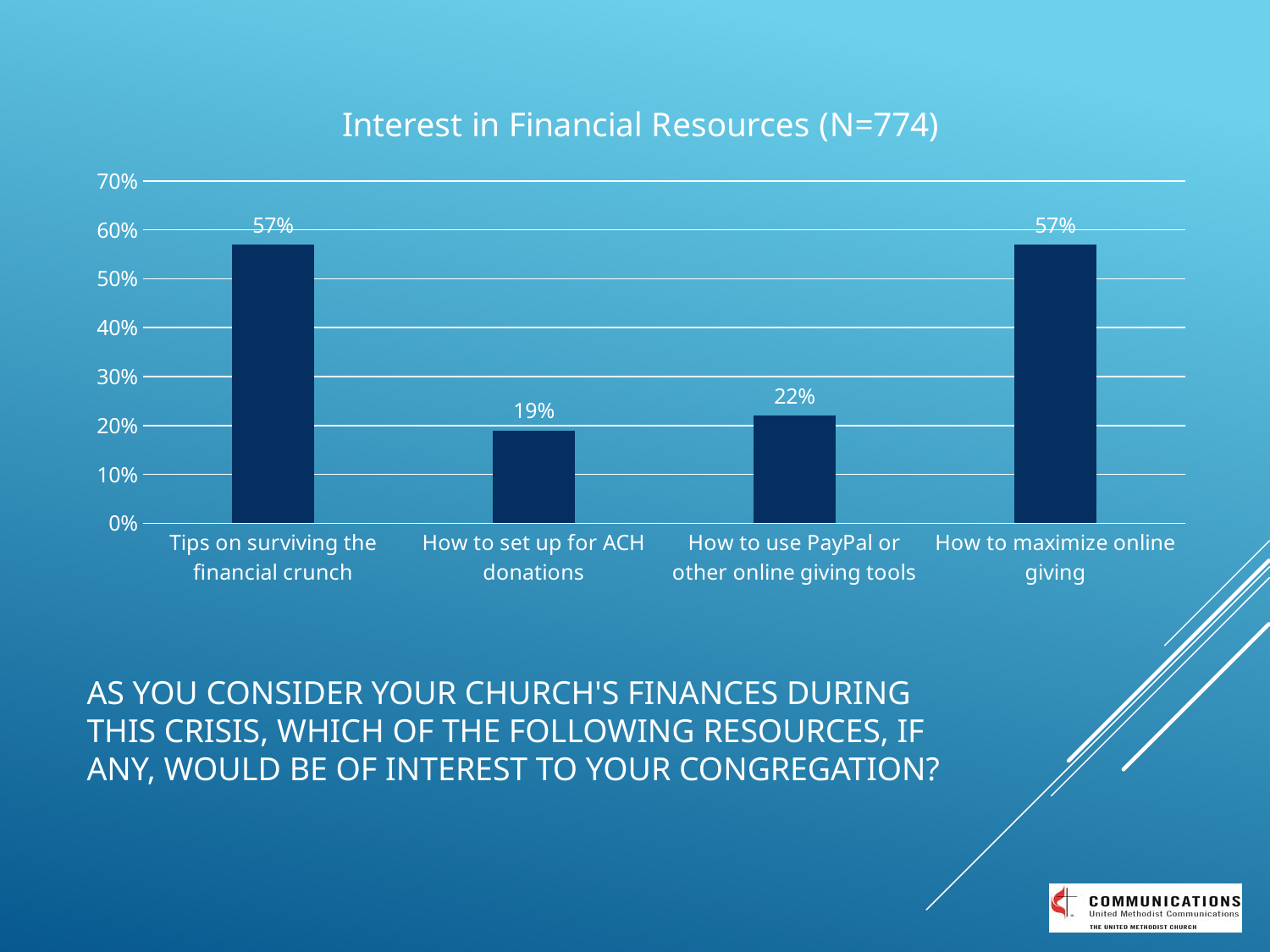
What is the value for "Tips on surviving the financial crunch"? 57% What is the difference between the values for "How to use PayPal or other online giving tools" and "How to set up for ACH donations"? 3% What is the difference between the values for "Tips on surviving the financial crunch" and "How to set up for ACH donations"? 38% How many categories are shown in the chart? 4 What is the value for "How to use PayPal or other online giving tools"? 22% Is the value for "How to use PayPal or other online giving tools" greater or less than 30%? less What is the title of the chart? Interest in Financial Resources (N=774) Which is larger, the value for "How to maximize online giving" or the value for "How to use PayPal or other online giving tools"? How to maximize online giving Which category has the lowest value? How to set up for ACH donations What is the value for "How to maximize online giving"? 57% What is the value for "How to set up for ACH donations"? 19% What kind of chart is shown on the slide? bar chart